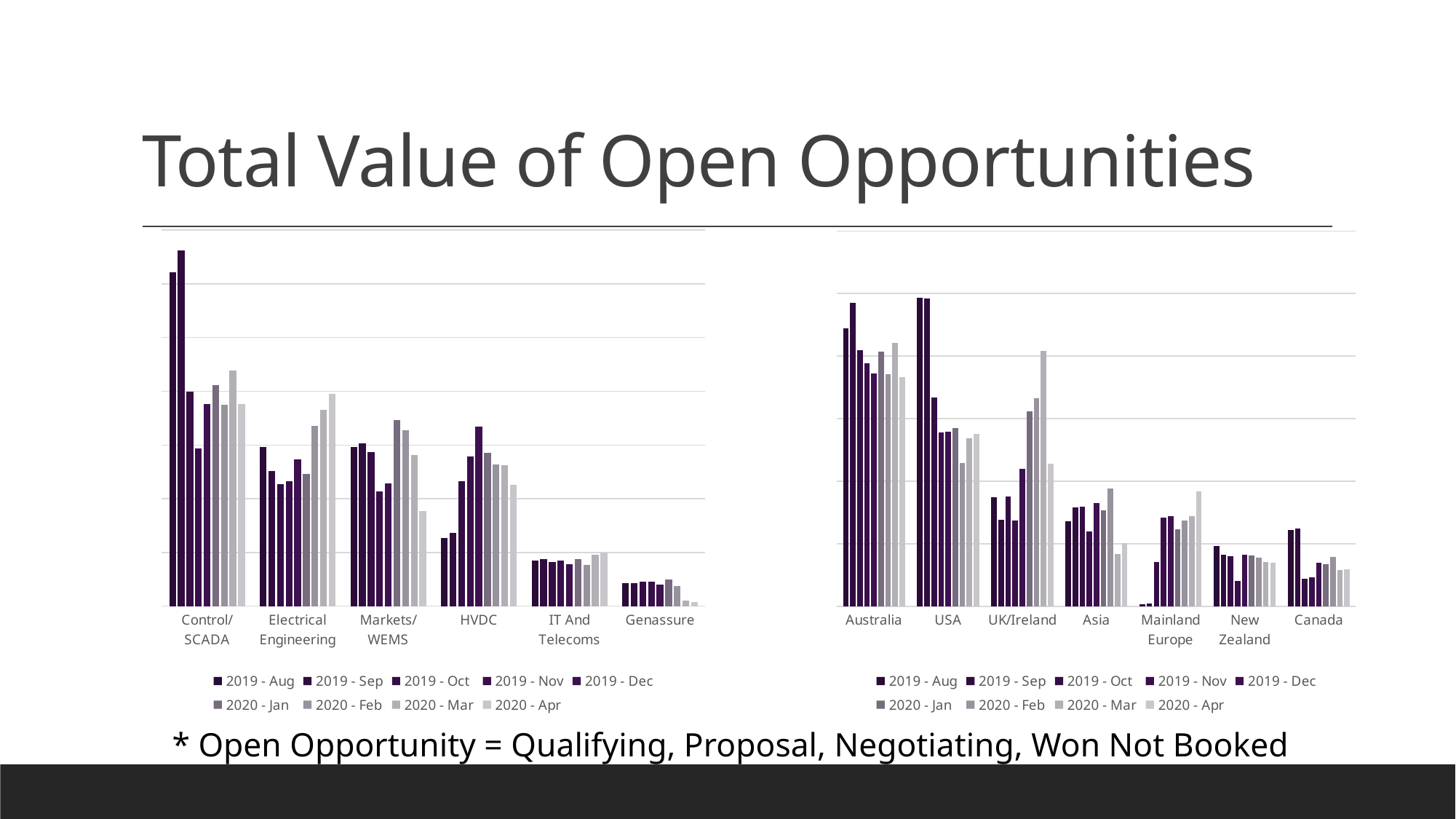
How many categories does the left chart show? 6 How many categories does the right chart show? 7 In the right chart, which is larger for 2019 - Aug: Australia or Canada? Australia In the right chart, which category contains the tallest bar? USA How many series does the legend of the right chart list? 9 In the right chart, which category has the smallest bar for 2019 - Aug? Mainland Europe In the left chart, which is larger for 2019 - Aug: Control/SCADA or Electrical Engineering? Control/SCADA In the left chart, which category contains the tallest bar? Control/SCADA What kind of chart is the left chart on the slide? bar chart How many series does the legend of the left chart list? 9 In the right chart, do the values for USA generally rise or fall from 2019 - Aug to 2020 - Apr? fall In the left chart, which category has the lowest values overall? Genassure